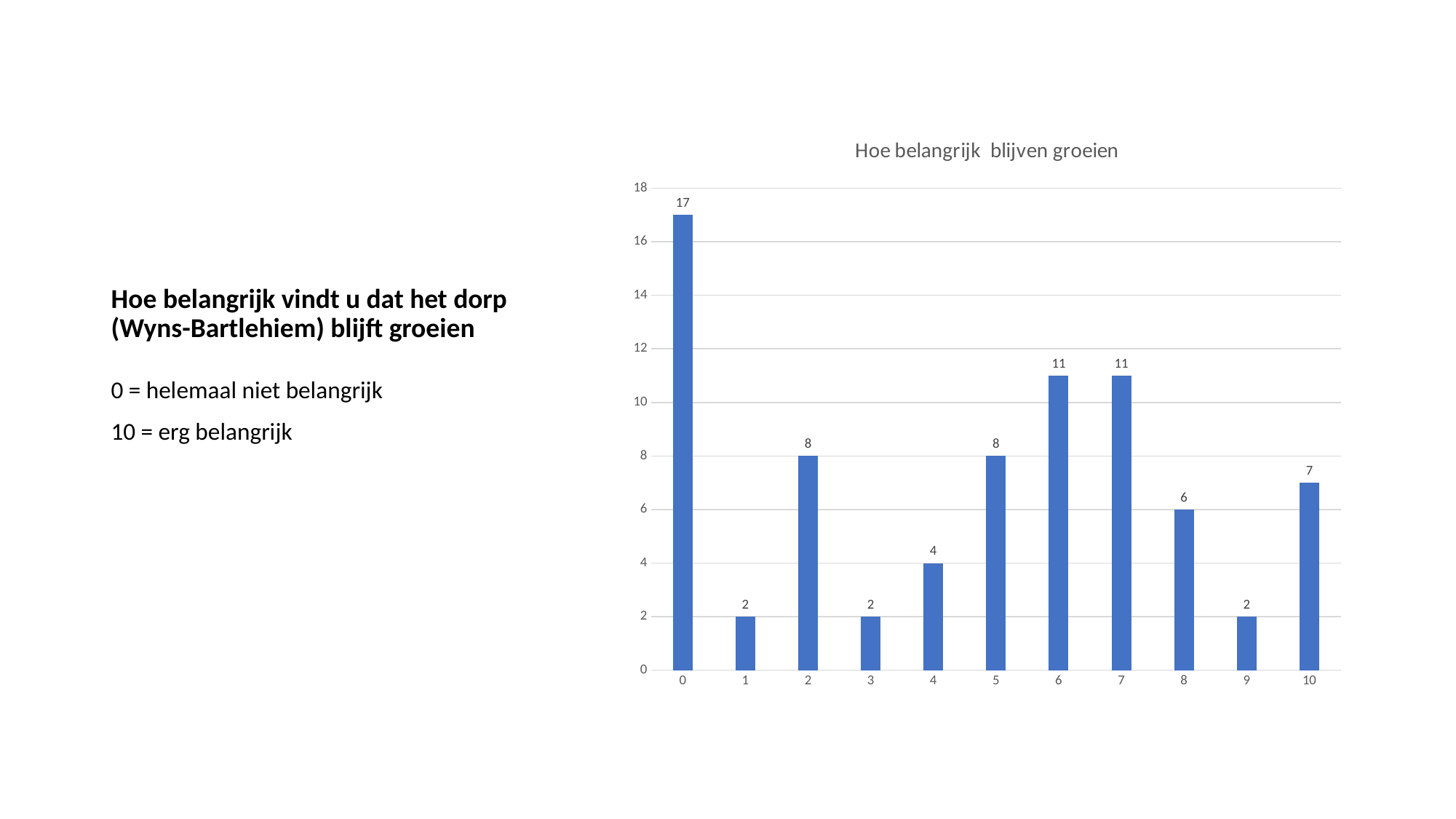
What is the difference between the values for category 0 and category 7? 6 What kind of chart is shown on the slide? bar chart How many categories are shown on the x axis? 11 Which category has the highest value? 0 What is the title of the chart? Hoe belangrijk blijven groeien Is the value for category 0 greater or less than 16? greater What is the value for category 8? 6 What is the difference between the values for category 5 and category 4? 4 Which is larger, the value for category 2 or the value for category 8? category 2 What is the value for category 10? 7 What is the value for category 0? 17 What is the value for category 6? 11